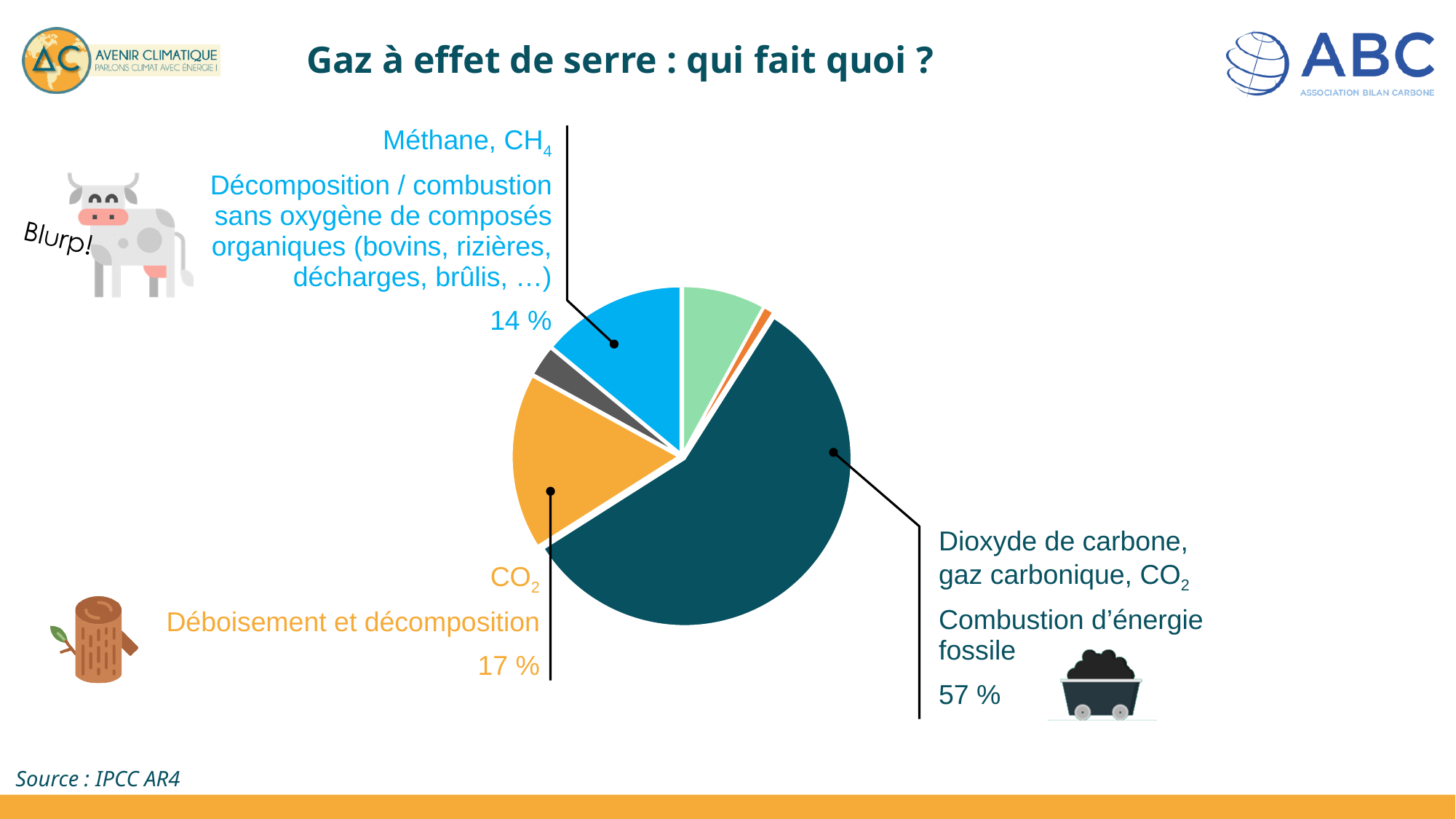
What share of the pie is labelled for CO2 from combustion d'énergie fossile? 57 % What share of the pie is labelled for CO2 from déboisement et décomposition? 17 % What kind of chart is shown on the slide? pie chart What share of the pie is labelled for Méthane, CH4? 14 % Which is larger: the Méthane slice or the déboisement et décomposition slice? Déboisement et décomposition Which labelled slice of the pie is the largest? Combustion d'énergie fossile (CO2), 57 % How many slices does the pie chart have? 6 What is the title of the slide containing the pie chart? Gaz à effet de serre : qui fait quoi ? What is the difference in percentage points between the déboisement et décomposition slice and the Méthane slice? 3 Which labelled slice of the pie is the smallest? Méthane, CH4, 14 % Is the share for combustion d'énergie fossile greater or less than 50 %? greater What is the difference in percentage points between the combustion d'énergie fossile slice and the déboisement et décomposition slice? 40